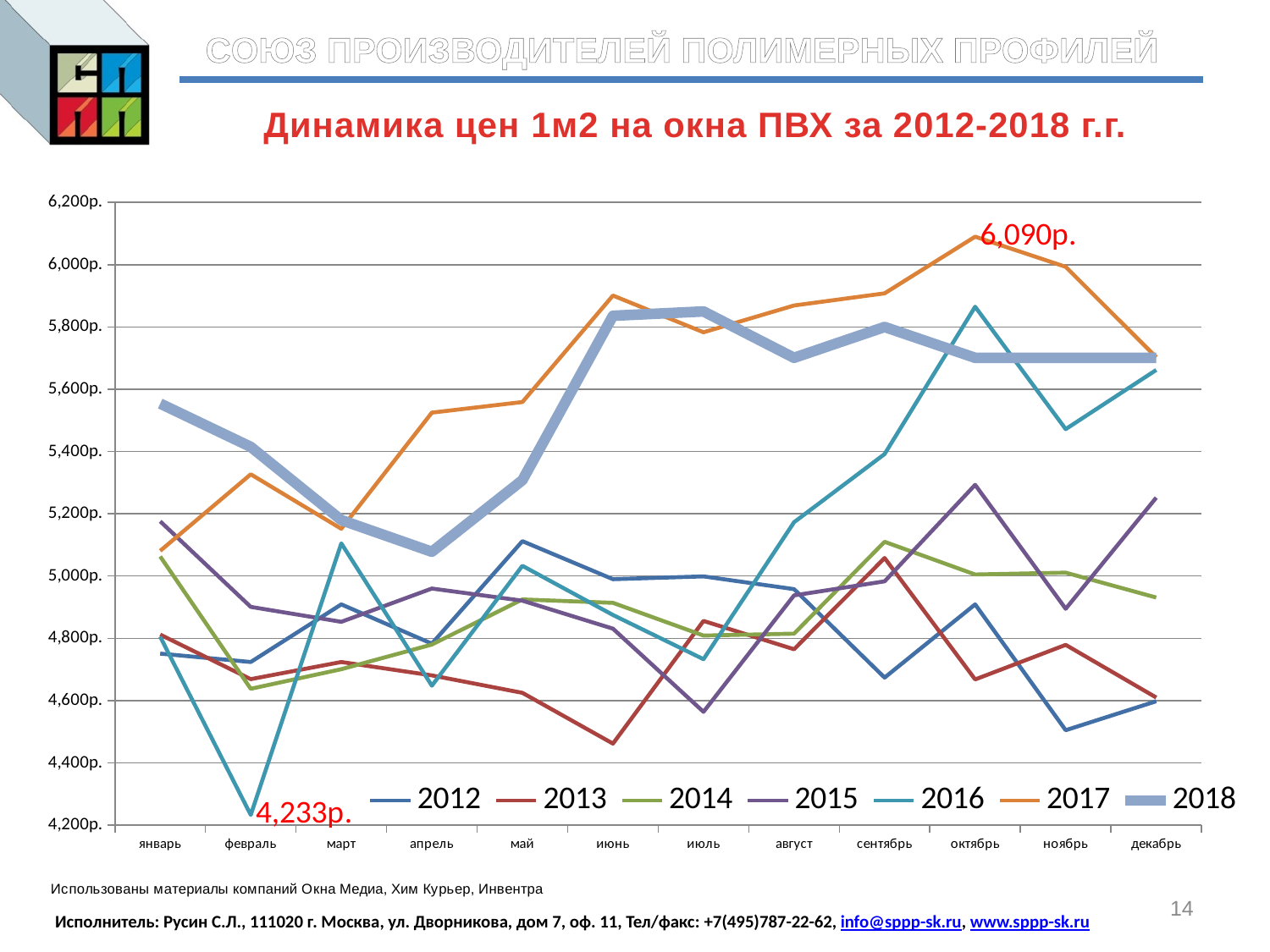
In июнь, which is larger: the value for 2017 or the value for 2012? 2017 Does the 2017 series rise or fall from октябрь to декабрь? fall What kind of chart is shown on the slide? line chart Is the value for 2013 in июнь greater or less than 4,600р.? less What is the labelled value for 2016 in февраль? 4,233р. What is the difference between the labelled 2017 value in октябрь and the labelled 2016 value in февраль? 1,857р. Is the value for 2018 in январь greater or less than 5,400р.? greater How many series does the legend list? 7 Which series has the lowest value in февраль? 2016 What is the labelled value for 2017 in октябрь? 6,090р. How many months are shown along the x axis? 12 Which series has the highest value in октябрь? 2017